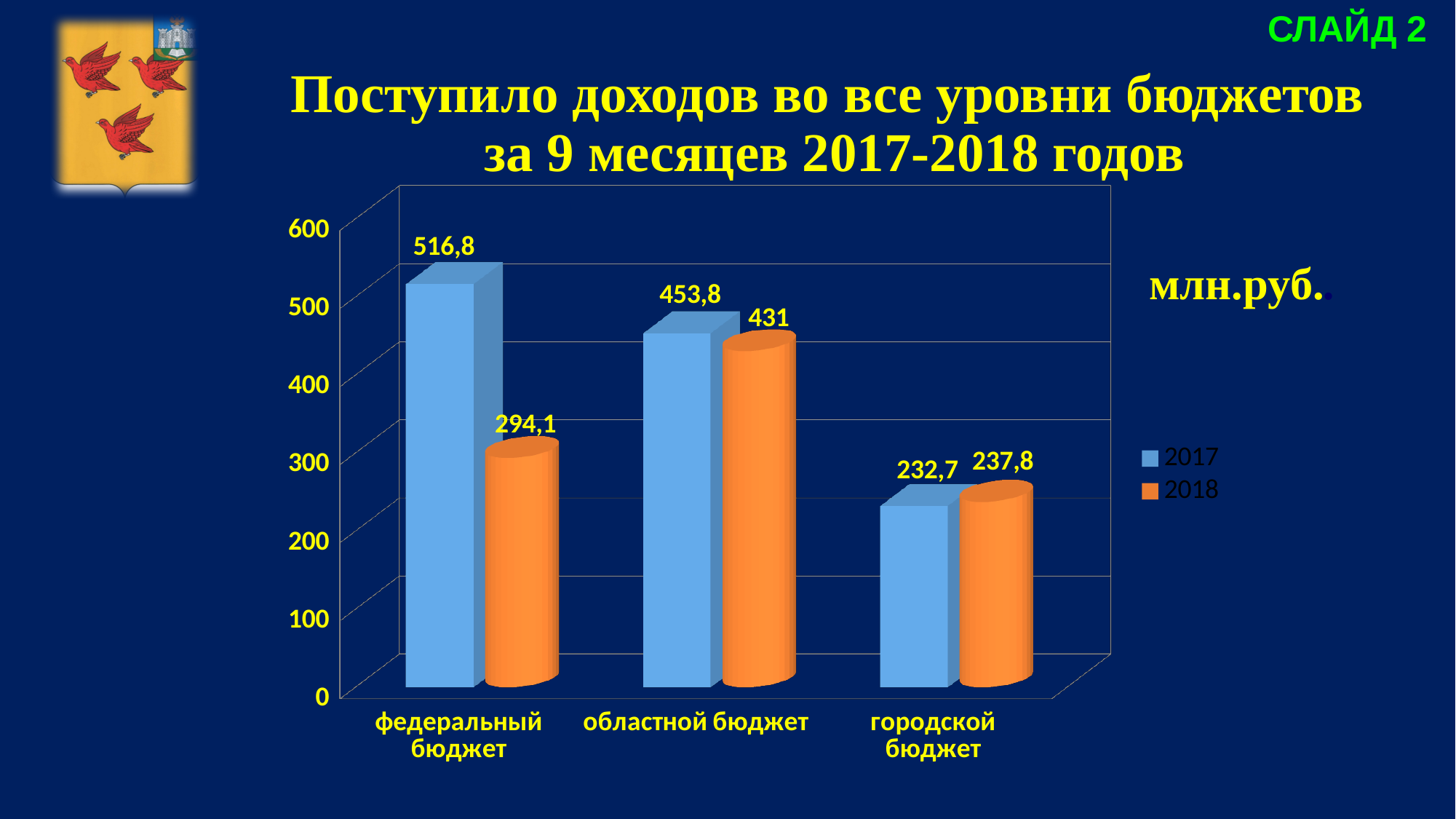
How many categories are shown on the x axis? 3 What is the 2018 value for городской бюджет? 237,8 What is the 2017 value for федеральный бюджет? 516,8 What kind of chart is shown on the slide? bar chart What is the difference between the 2017 and 2018 values for федеральный бюджет? 222,7 Which category has the highest 2017 value? федеральный бюджет Which category has the lowest 2018 value? городской бюджет What is the 2018 value for областной бюджет? 431 What unit is indicated next to the chart? млн.руб. Which is larger for областной бюджет: the 2017 value or the 2018 value? 2017 How many series does the legend list? 2 Is the 2018 value for федеральный бюджет greater or less than 300? less